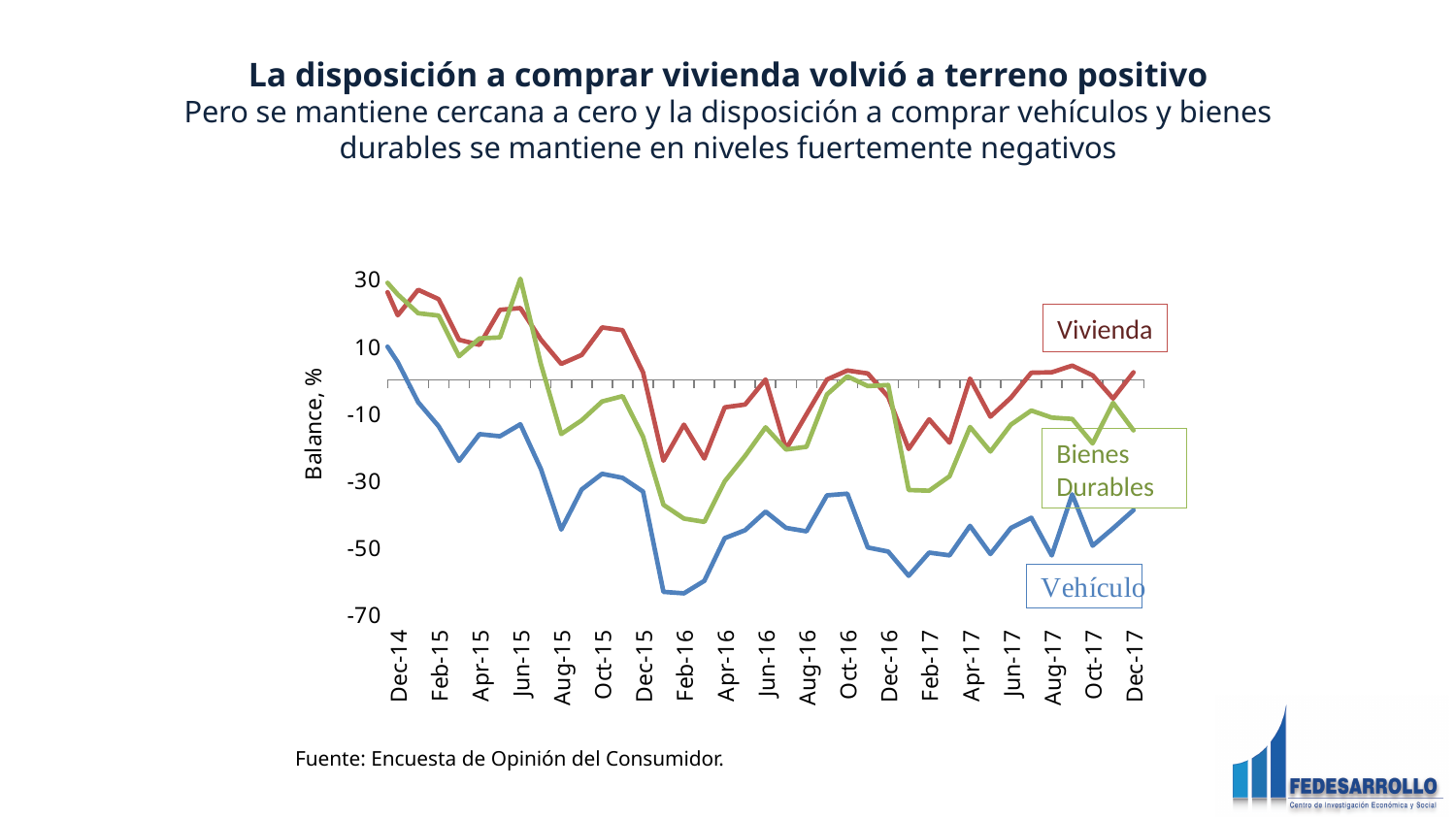
What kind of chart is shown on the slide? Line chart Is the value for Bienes Durables in Feb-16 greater or less than -30? less In Dec-17, which series has the higher value, Vivienda or Vehículo? Vivienda What is the label of the vertical axis? Balance, % Is the value for Vehículo in Feb-16 greater or less than -50? less What are the names of the three series plotted on the chart? Vivienda, Bienes Durables, Vehículo Is the value for Vivienda in Dec-17 greater or less than -10? greater How many series are plotted on the chart? 3 Which series has the lowest values over most of the period shown? Vehículo Does the Vehículo series rise or fall between Dec-14 and Feb-16? Fall